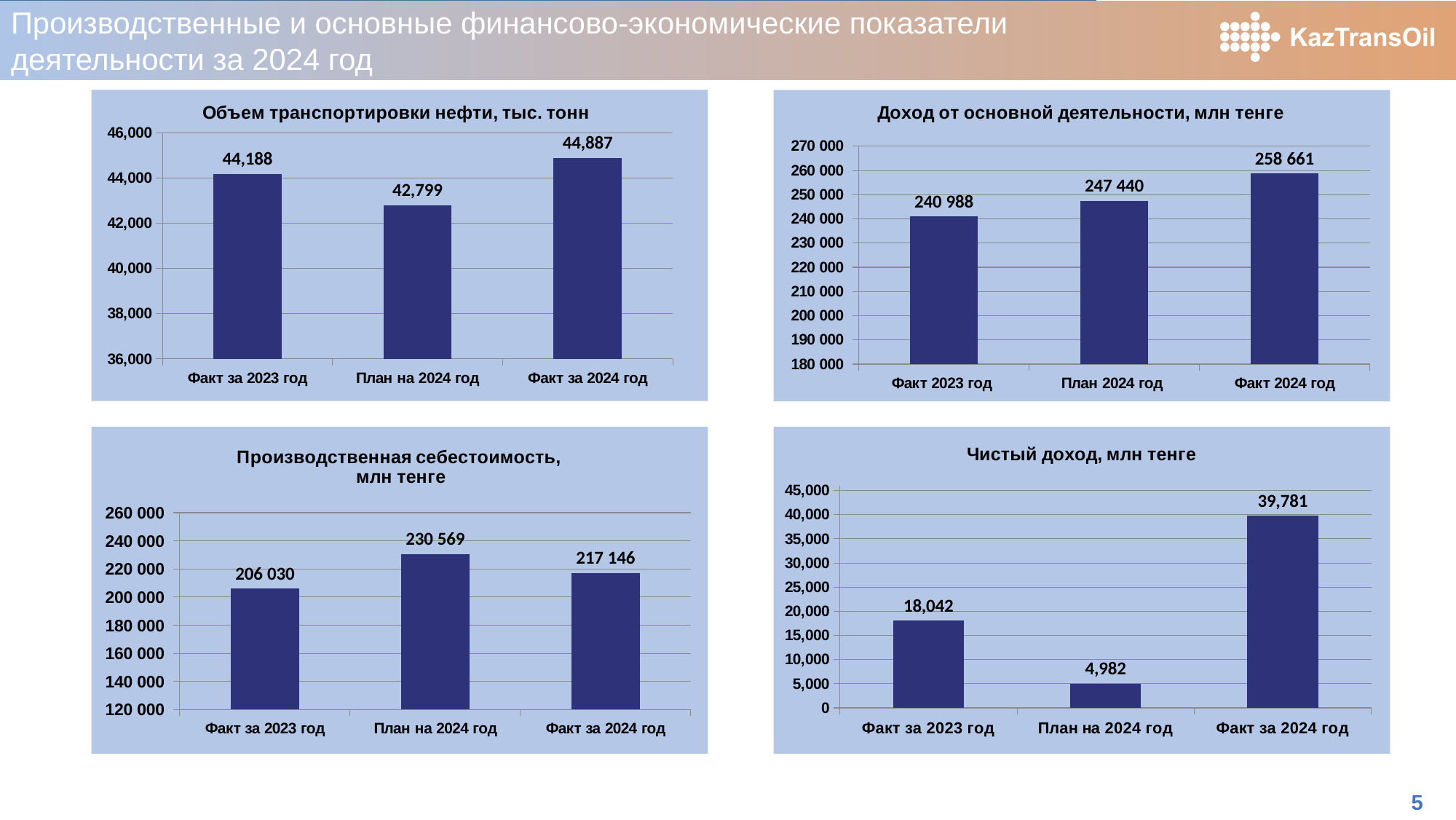
In the chart 'Производственная себестоимость, млн тенге', what is the value for 'Факт за 2024 год'? 217 146 What type of chart is 'Объем транспортировки нефти, тыс. тонн'? bar chart In the chart 'Чистый доход, млн тенге', what is the value for 'План на 2024 год'? 4,982 How many categories are shown in the chart 'Чистый доход, млн тенге'? 3 In the chart 'Производственная себестоимость, млн тенге', which category has the highest value? План на 2024 год In the chart 'Доход от основной деятельности, млн тенге', do the values rise or fall from left to right? rise In the chart 'Доход от основной деятельности, млн тенге', what is the difference between 'Факт 2024 год' and 'План 2024 год'? 11 221 In the chart 'Доход от основной деятельности, млн тенге', what is the value for 'Факт 2023 год'? 240 988 In the chart 'Объем транспортировки нефти, тыс. тонн', which category has the lowest value? План на 2024 год In the chart 'Чистый доход, млн тенге', what is the difference between 'Факт за 2024 год' and 'Факт за 2023 год'? 21,739 In the chart 'Объем транспортировки нефти, тыс. тонн', what is the value for 'Факт за 2024 год'? 44,887 In the chart 'Производственная себестоимость, млн тенге', which is larger: 'Факт за 2023 год' or 'Факт за 2024 год'? Факт за 2024 год